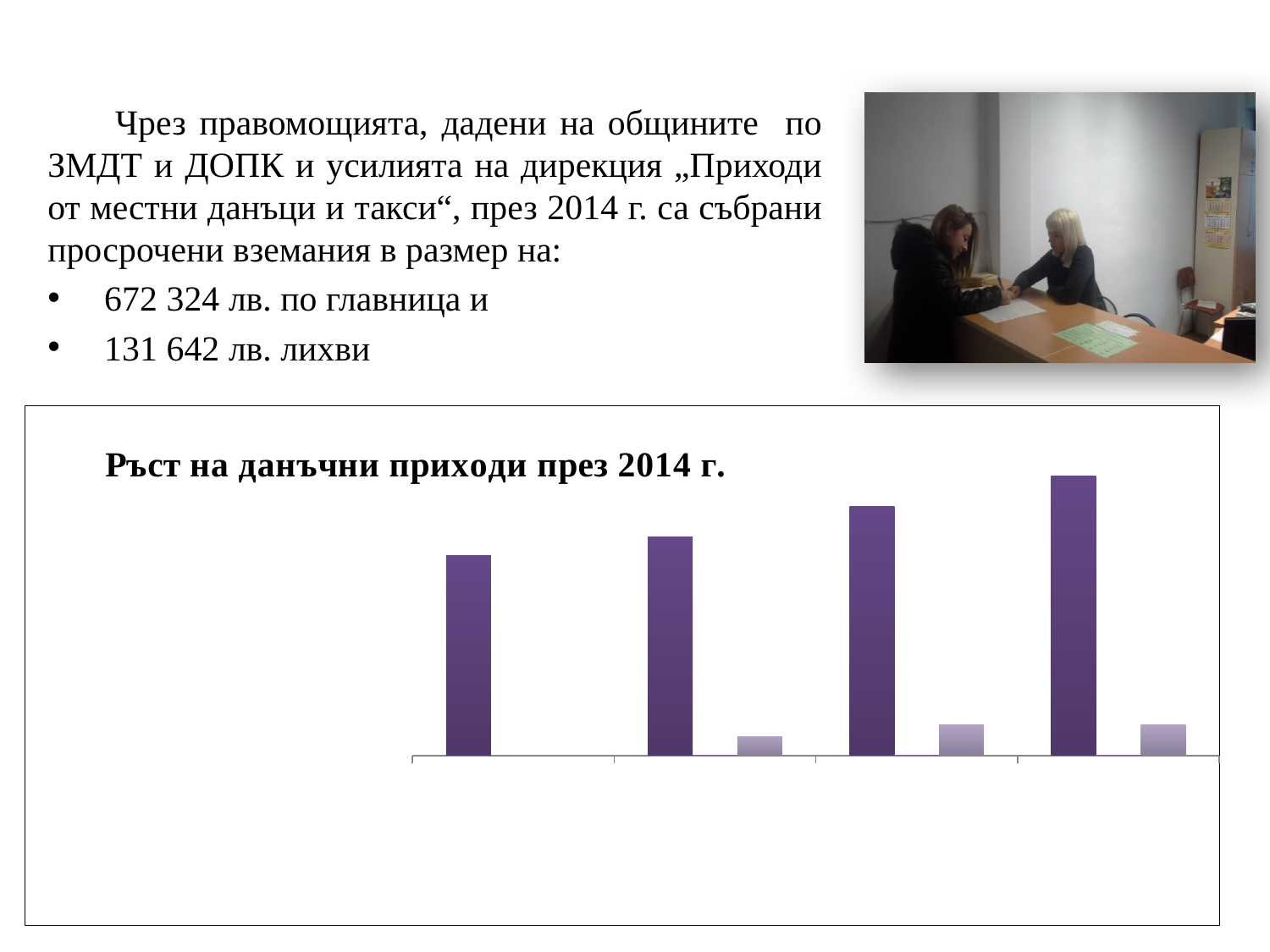
Do the tall purple bars rise or fall from left to right across the chart? rise How many groups of bars are plotted in the chart? 4 What colour are the tallest bars in the chart? purple What kind of chart is shown on the slide? bar chart What is the title of the chart on the slide? Ръст на данъчни приходи през 2014 г. Which group of bars, counting from the left, has the shortest purple bar? the first (leftmost) In each group, is the purple bar taller or shorter than the grey bar? taller Which group of bars, counting from the left, has the tallest purple bar? the fourth (rightmost)